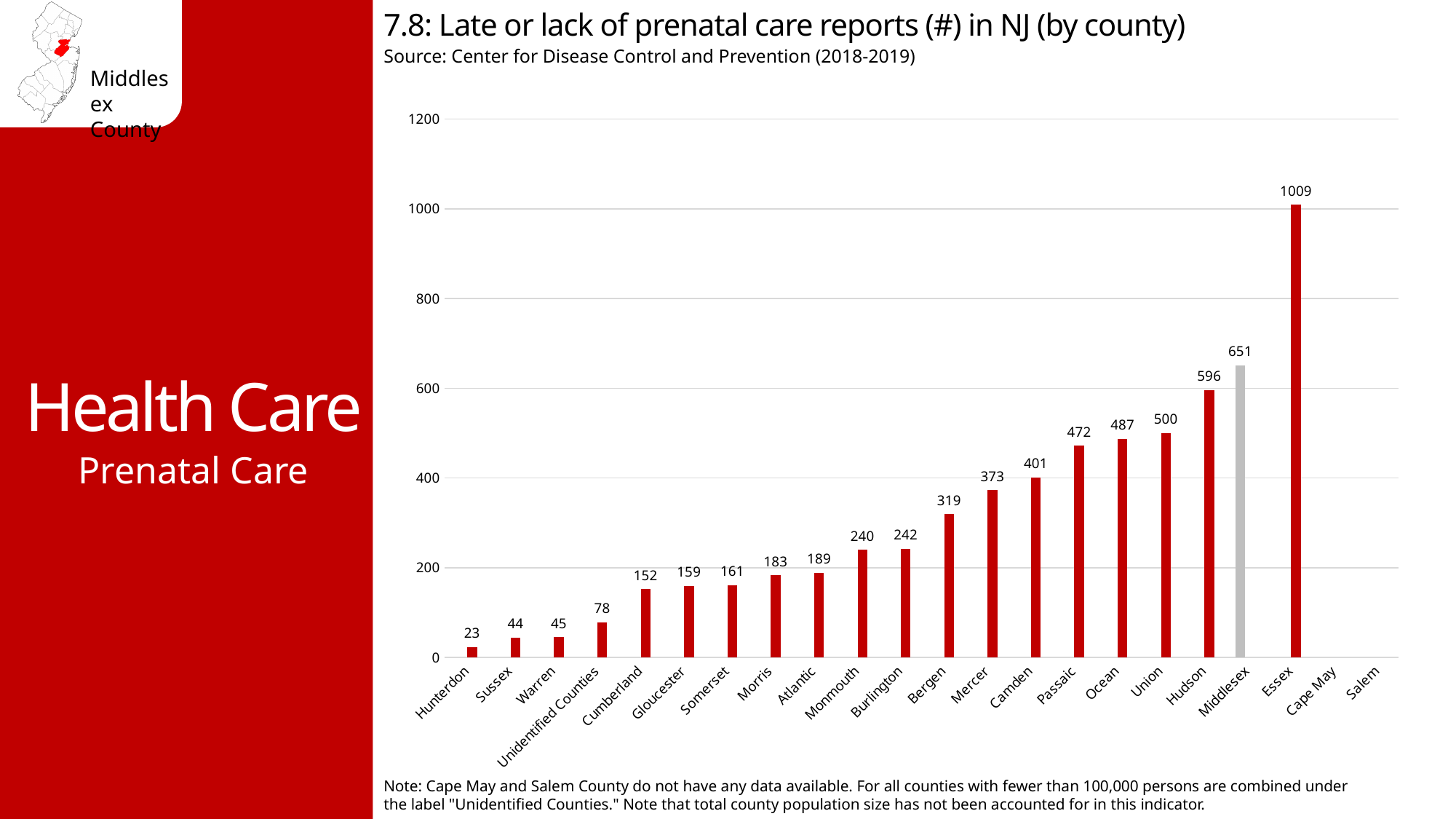
What kind of chart is shown on the slide? bar chart Which is larger, the value for Hudson or the value for Union? Hudson Which county has the highest number of late or lack of prenatal care reports? Essex What is the value for Essex? 1009 Is the value for Bergen greater or less than 400? less What is the value for Hunterdon? 23 What is the difference between the values for Essex and Middlesex? 358 What is the value for Middlesex? 651 How many county labels are shown on the x axis? 22 What is the value for Unidentified Counties? 78 Which bar is coloured grey instead of red? Middlesex Which county with a plotted bar has the lowest value? Hunterdon